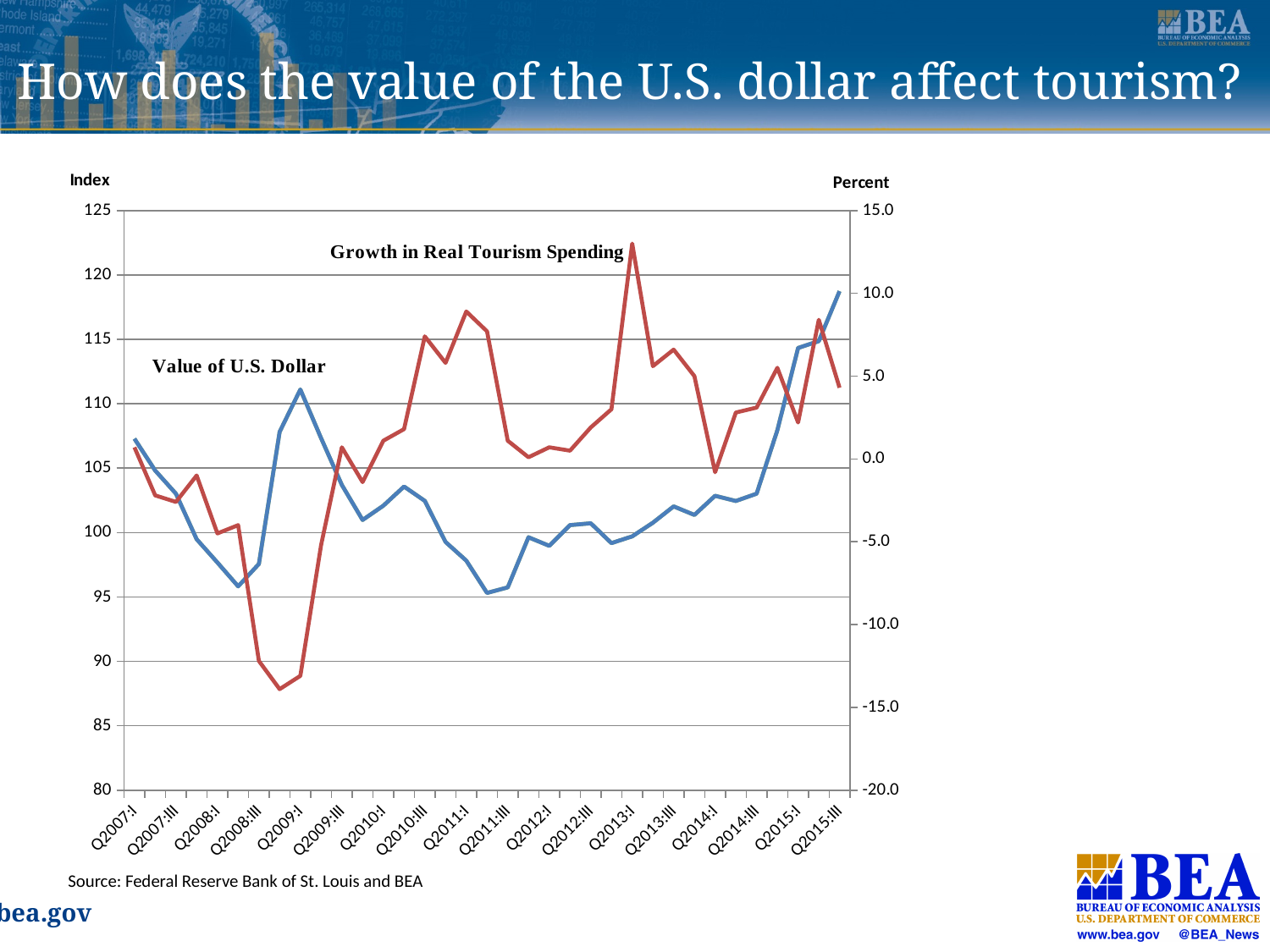
What kind of chart is shown on the slide? line chart Is the Value of U.S. Dollar at Q2015:III greater or less than 115? greater Is Growth in Real Tourism Spending at Q2008:III greater or less than -10.0? less How many data series are plotted on the chart? 2 What is the title of the left vertical axis? Index Which series is plotted in red? Growth in Real Tourism Spending Is Growth in Real Tourism Spending at Q2013:I greater or less than 10.0? greater Does the Value of U.S. Dollar rise or fall from Q2014:I to Q2015:III? rise In which quarter does Growth in Real Tourism Spending reach its highest point? Q2013:I In which quarter does the Value of U.S. Dollar reach its highest point? Q2015:III